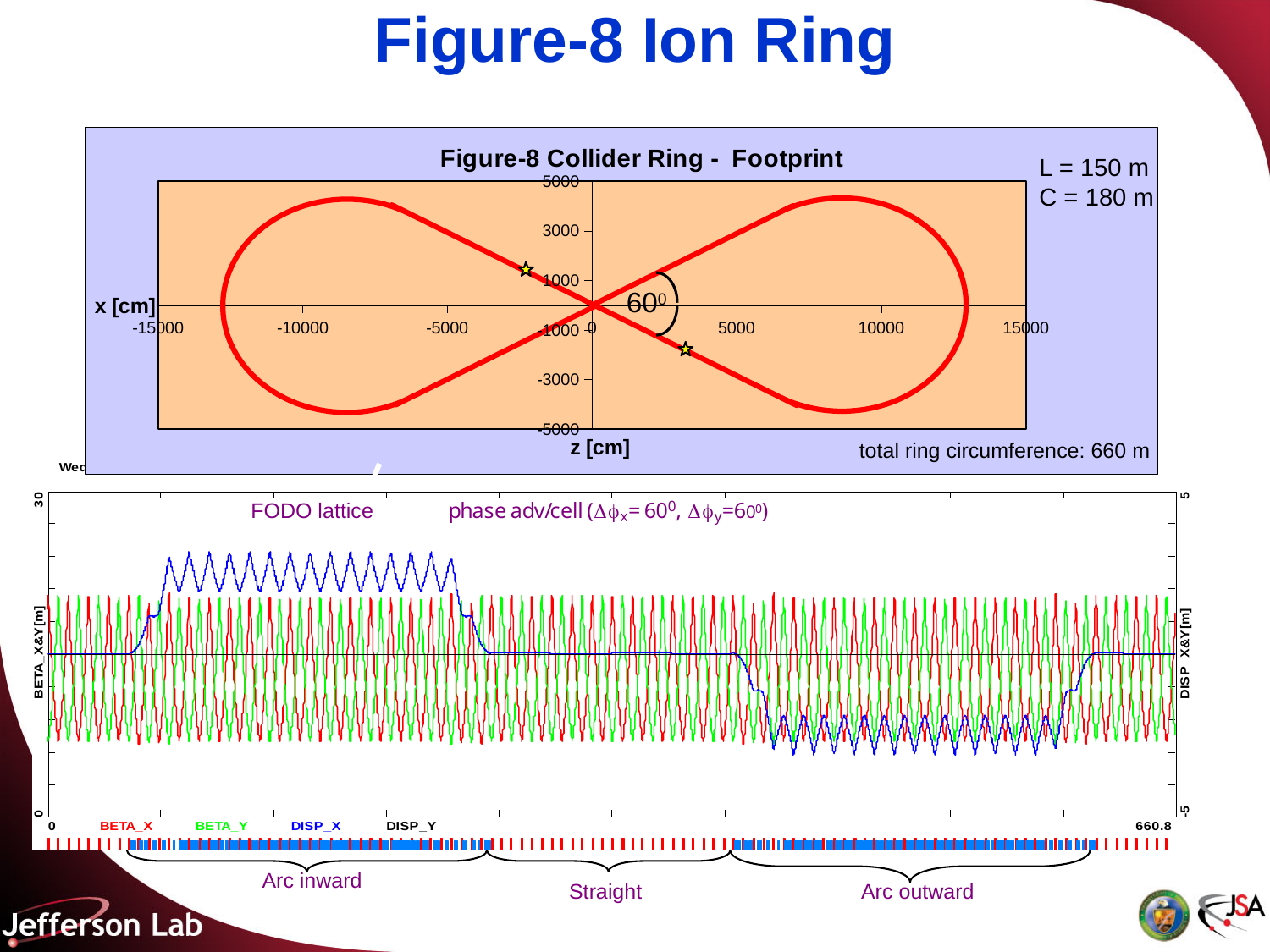
In the bottom lattice chart, what is the last value shown on the horizontal axis? 660.8 How many series does the legend of the bottom lattice chart list? 4 In the top chart, what is the maximum value shown on the horizontal z [cm] axis? 15000 In the bottom lattice chart, is the DISP_X value in the Arc inward section greater or less than 0? greater In the top chart, what angle is marked at the crossing point of the figure-8? 60° In the top chart, what is the value given for C? C = 180 m In the bottom lattice chart, what is the maximum value on the left BETA_X&Y[m] axis? 30 In the top chart, what is the value given for L? L = 150 m What kind of chart is the top Figure-8 Collider Ring - Footprint chart? line chart What is the title of the top chart? Figure-8 Collider Ring - Footprint In the bottom lattice chart, which series is drawn in blue? DISP_X In the top chart, what is the total ring circumference stated? 660 m